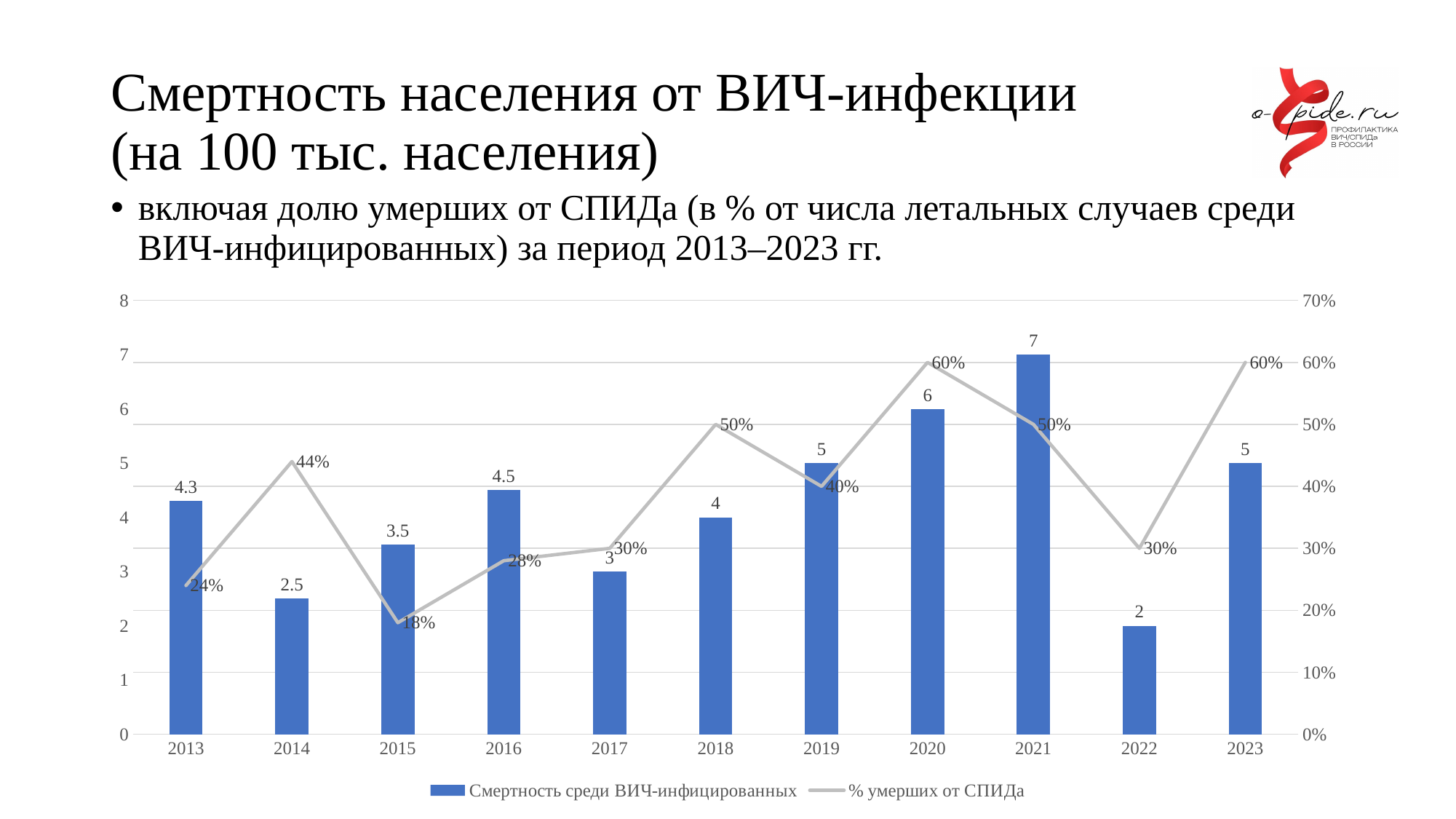
What is the difference between the Смертность среди ВИЧ-инфицированных values for 2021 and 2022? 5 Which year has the lowest value of Смертность среди ВИЧ-инфицированных? 2022 What is the value of Смертность среди ВИЧ-инфицированных for 2013? 4.3 Which year has the highest value of Смертность среди ВИЧ-инфицированных? 2021 Does the Смертность среди ВИЧ-инфицированных value rise or fall from 2017 to 2021? Rise What is the value of Смертность среди ВИЧ-инфицированных for 2021? 7 What is the value of % умерших от СПИДа for 2015? 18% Which year has the lowest value of % умерших от СПИДа? 2015 Which is larger, the % умерших от СПИДа value for 2014 or for 2017? 2014 What kinds of chart are combined on this slide? Bar chart and line chart How many years are shown on the x axis? 11 How many series does the legend list? 2